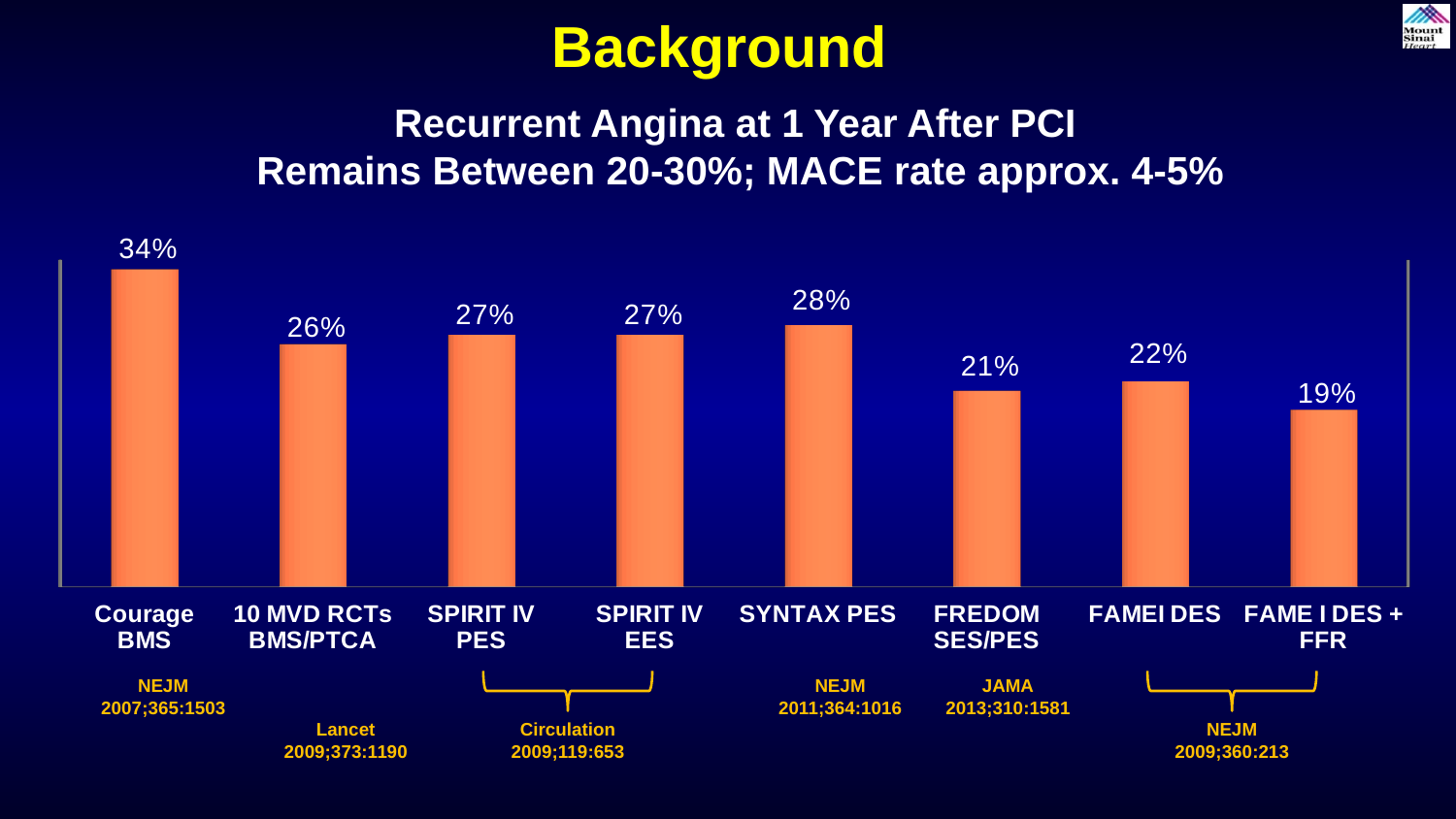
Which category has the highest value? Courage BMS How many categories are shown in the chart? 8 Which is larger, the value for 10 MVD RCTs BMS/PTCA or the value for FAMEI DES? 10 MVD RCTs BMS/PTCA What value is shown for FAME I DES + FFR? 19% What value is shown for FREDOM SES/PES? 21% Which category has the lowest value? FAME I DES + FFR What is the difference between the values for Courage BMS and FAME I DES + FFR? 15% What value is shown for SYNTAX PES? 28% What kind of chart is shown on the slide? Bar chart What is the difference between the values for SYNTAX PES and FREDOM SES/PES? 7% What is the recurrent angina rate shown for Courage BMS? 34% Which two categories share the same value of 27%? SPIRIT IV PES and SPIRIT IV EES